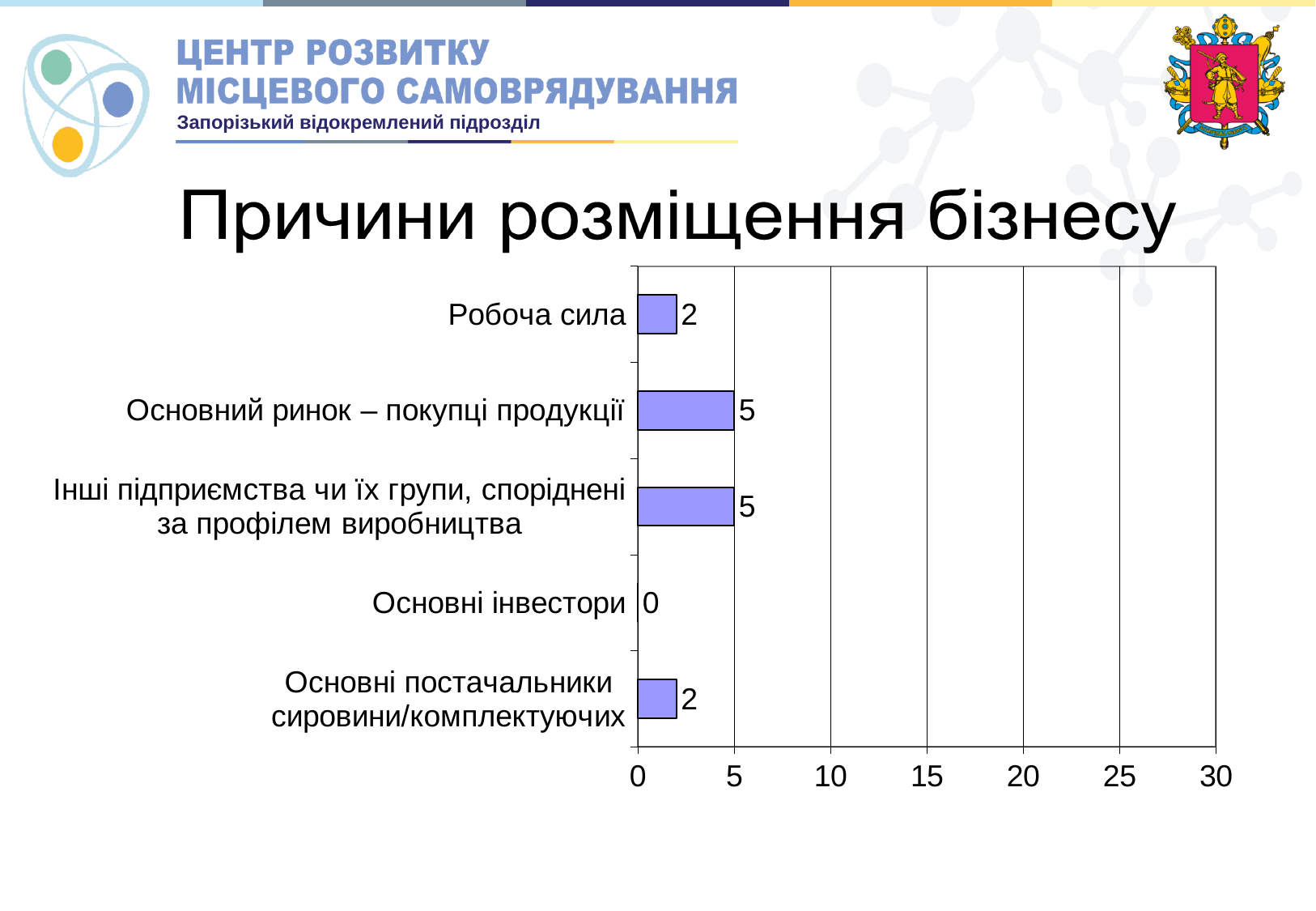
Is the value for Основний ринок – покупці продукції greater or less than 10? less Which category has the lowest value? Основні інвестори Which is larger: the value for Інші підприємства чи їх групи, споріднені за профілем виробництва or the value for Основні постачальники сировини/комплектуючих? Інші підприємства чи їх групи, споріднені за профілем виробництва What is the value for Основний ринок – покупці продукції? 5 What is the title of the slide? Причини розміщення бізнесу How many categories are shown in the chart? 5 What is the value for Основні інвестори? 0 What kind of chart is shown on the slide? bar chart What is the value for Робоча сила? 2 What is the difference between the values for Основний ринок – покупці продукції and Робоча сила? 3 What is the value for Основні постачальники сировини/комплектуючих? 2 What is the maximum value shown on the x axis? 30